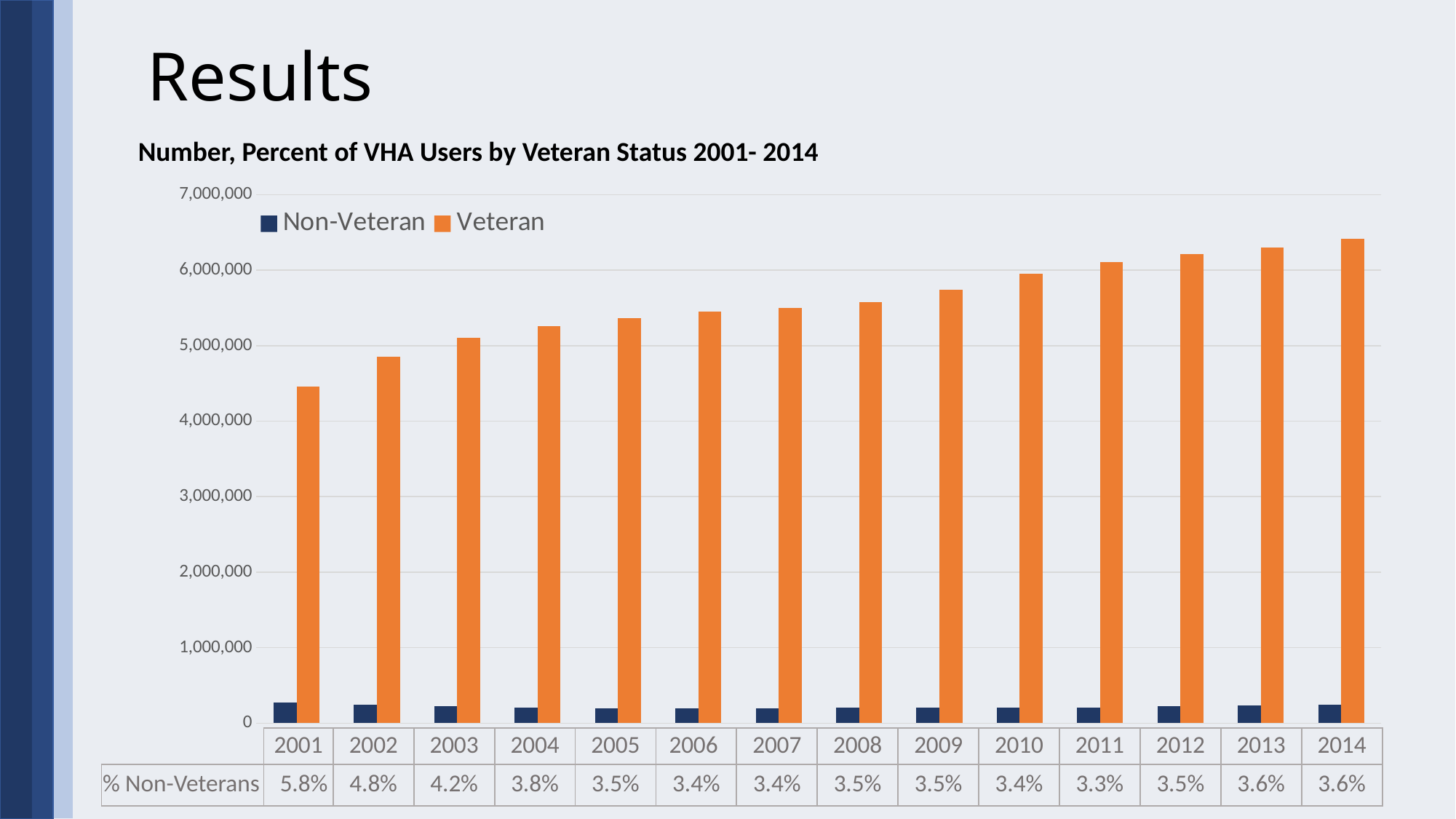
Is the Veteran value for 2001 greater or less than 5,000,000? less What is the % Non-Veterans value for 2011? 3.3% Which year has the highest % Non-Veterans value? 2001 What kind of chart is shown on the slide? bar chart By how many percentage points does the % Non-Veterans value for 2001 exceed that for 2014? 2.2 How many series does the legend list? 2 How many years are shown along the x axis? 14 Is the Veteran value for 2014 greater or less than 6,000,000? greater What is the % Non-Veterans value for 2001? 5.8% What is the % Non-Veterans value for 2014? 3.6% Do the Veteran bars rise or fall from 2001 to 2014? rise Which year has the lowest % Non-Veterans value? 2011